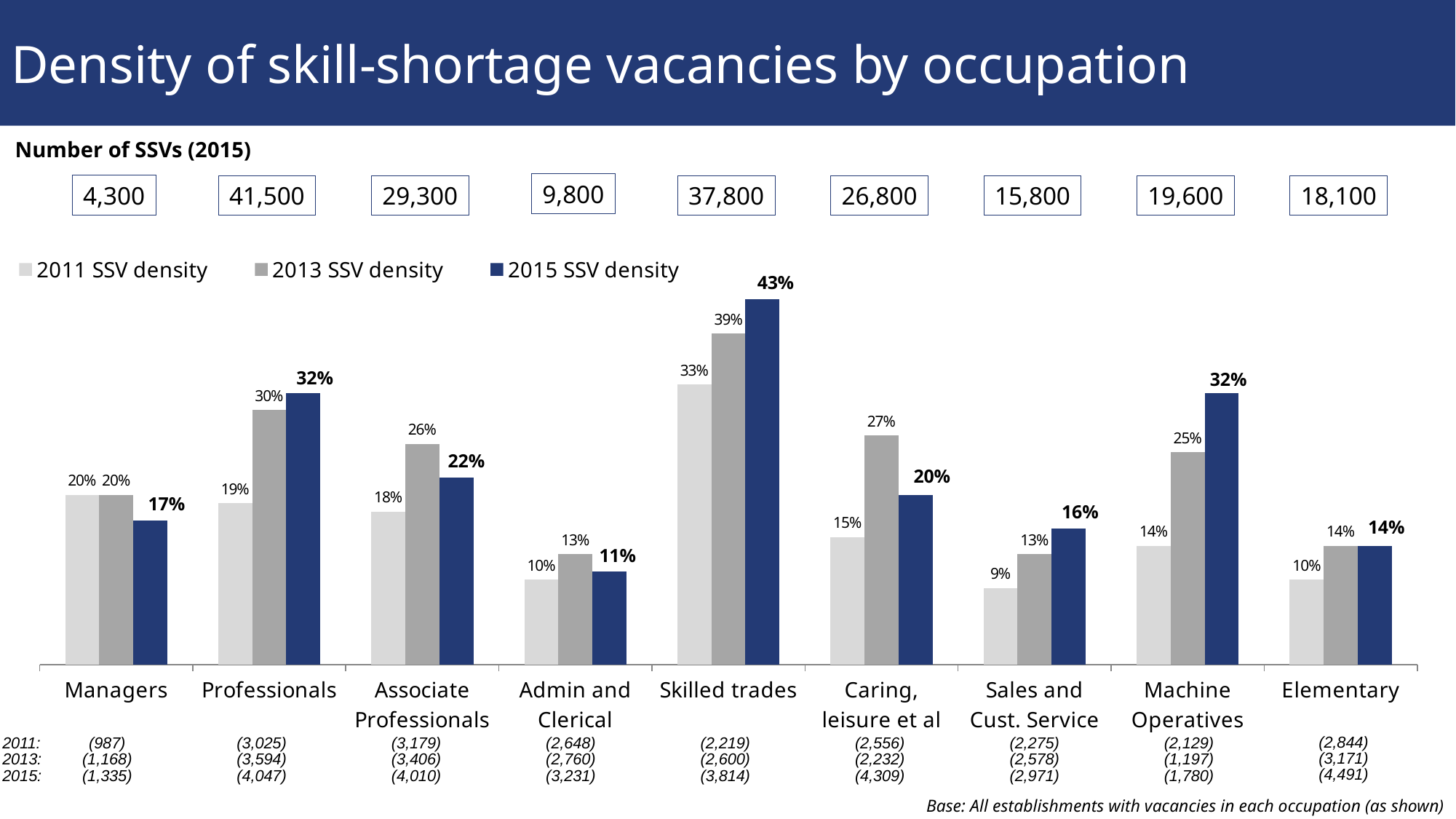
How many occupations are shown on the x axis? 9 What kind of chart is shown on the slide? Bar chart Which occupation has the lowest 2015 SSV density? Admin and Clerical What is the 2015 SSV density for Skilled trades? 43% Which occupation has the highest 2015 SSV density? Skilled trades Does the SSV density for Professionals rise or fall from 2011 to 2015? Rise What is the number of SSVs (2015) shown above the Professionals bars? 41,500 How many series does the legend list? 3 What is the 2011 SSV density for Sales and Cust. Service? 9% What is the 2013 SSV density for Caring, leisure et al? 27% Which is larger for Caring, leisure et al: the 2013 SSV density or the 2015 SSV density? 2013 SSV density What is the difference between the 2015 and 2011 SSV density for Machine Operatives? 18%